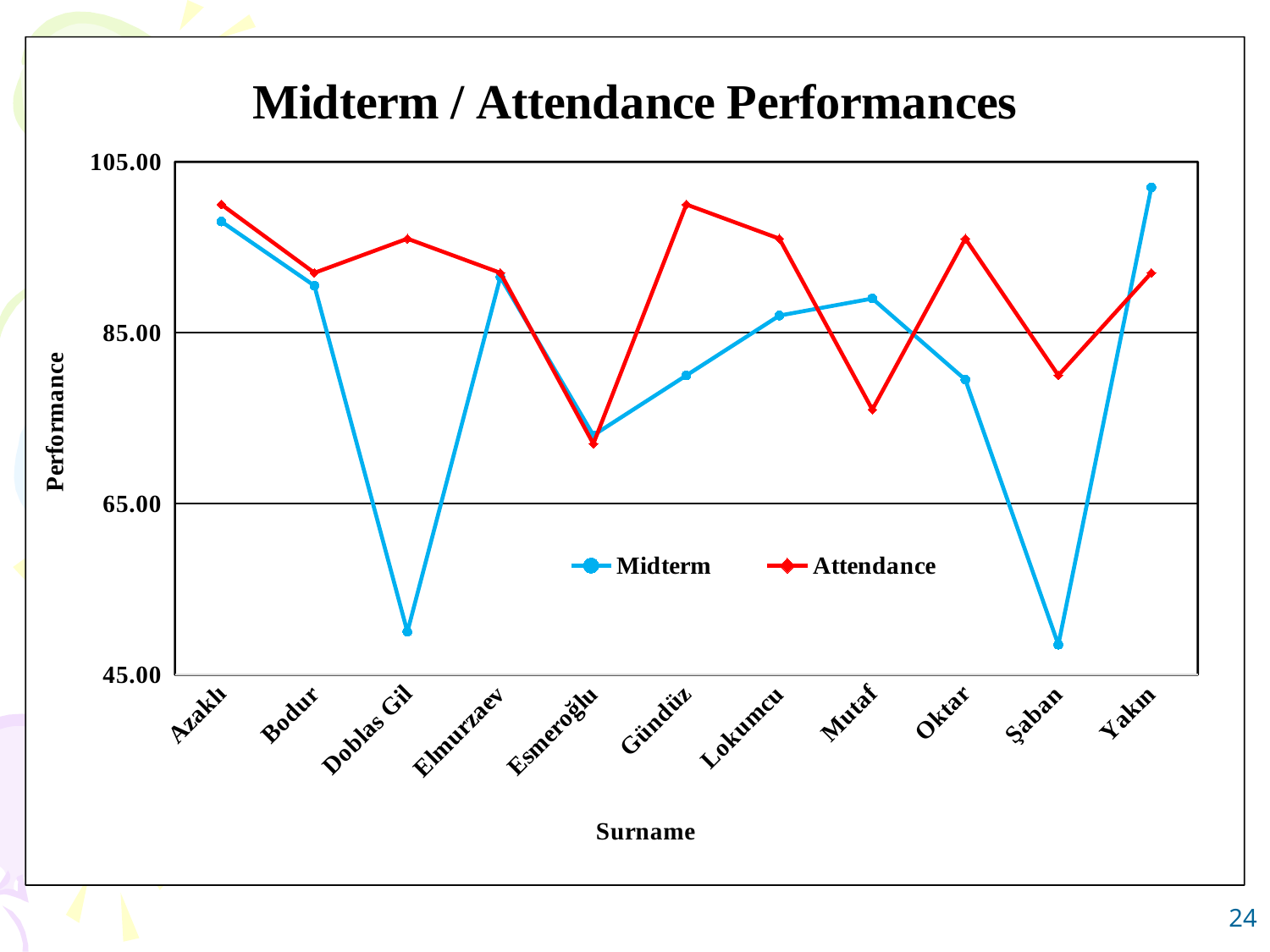
Which surname has the highest Midterm value? Yakın What is the title of the chart? Midterm / Attendance Performances Is the Midterm value for Doblas Gil greater or less than 65.00? less Which surname has the lowest Attendance value? Esmeroğlu For Doblas Gil, which is larger: the Midterm value or the Attendance value? Attendance How many series does the legend list? 2 For Mutaf, which is larger: the Midterm value or the Attendance value? Midterm Is the Attendance value for Gündüz greater or less than 85.00? greater Does the Midterm line rise or fall from Oktar to Şaban? fall Is the Midterm value for Şaban greater or less than 65.00? less How many surnames are plotted along the x axis? 11 What kind of chart is shown on the slide? Line chart